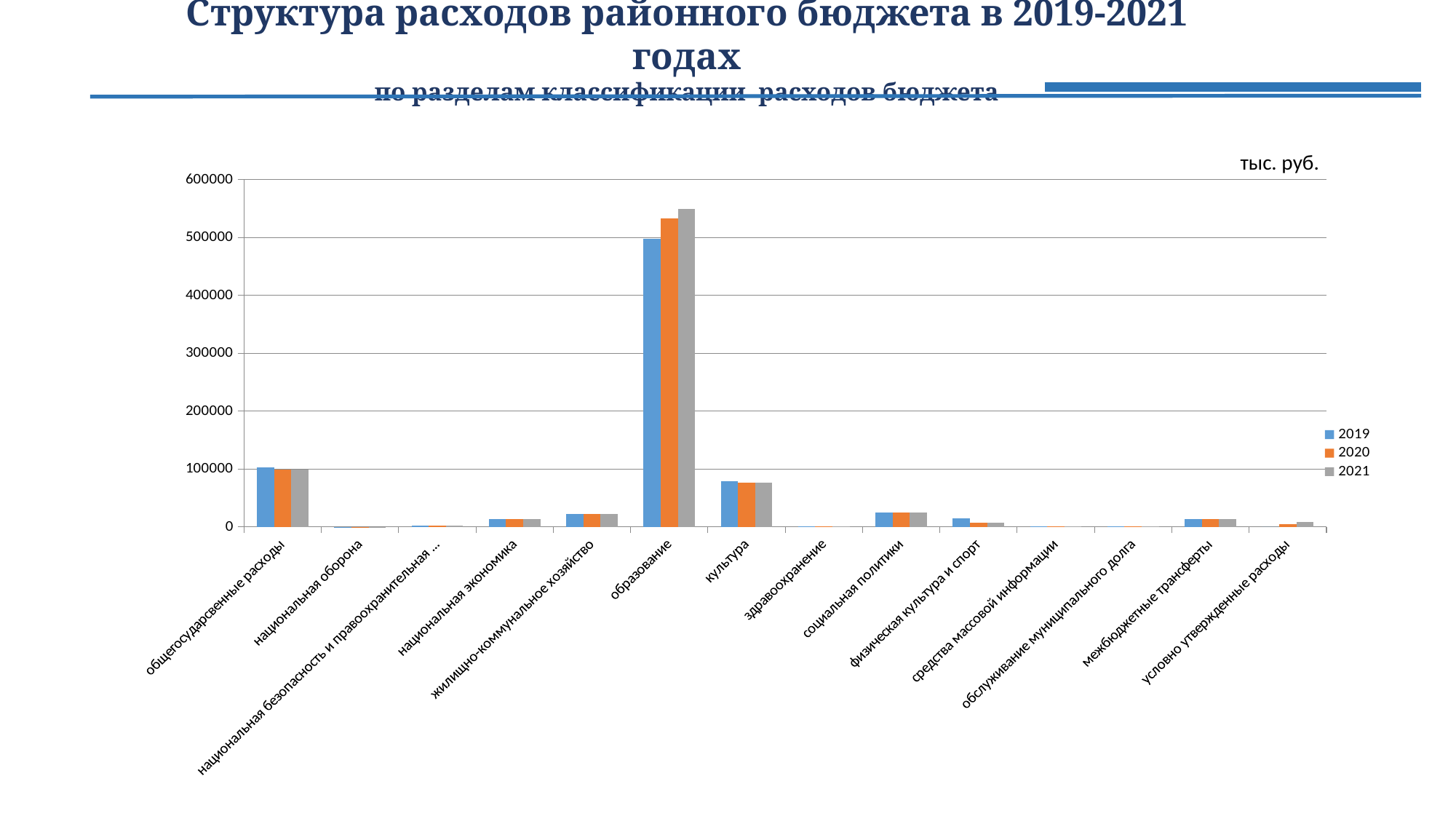
Do the values for образование rise or fall from 2019 to 2021? rise Is the 2020 value for культура greater or less than 100000? less Which is larger for 2020: образование or культура? образование For образование, which year has the larger value: 2019 or 2021? 2021 Is the 2021 value for образование greater or less than 500000? greater Which years are listed in the legend? 2019, 2020, 2021 What kind of chart is shown on the slide? bar chart How many series does the legend list? 3 Which category has the highest expenditure in all three years? образование Is the 2019 value for общегосударсвенные расходы greater or less than 200000? less What unit is indicated above the chart? тыс. руб. How many expenditure categories are shown on the x axis? 14